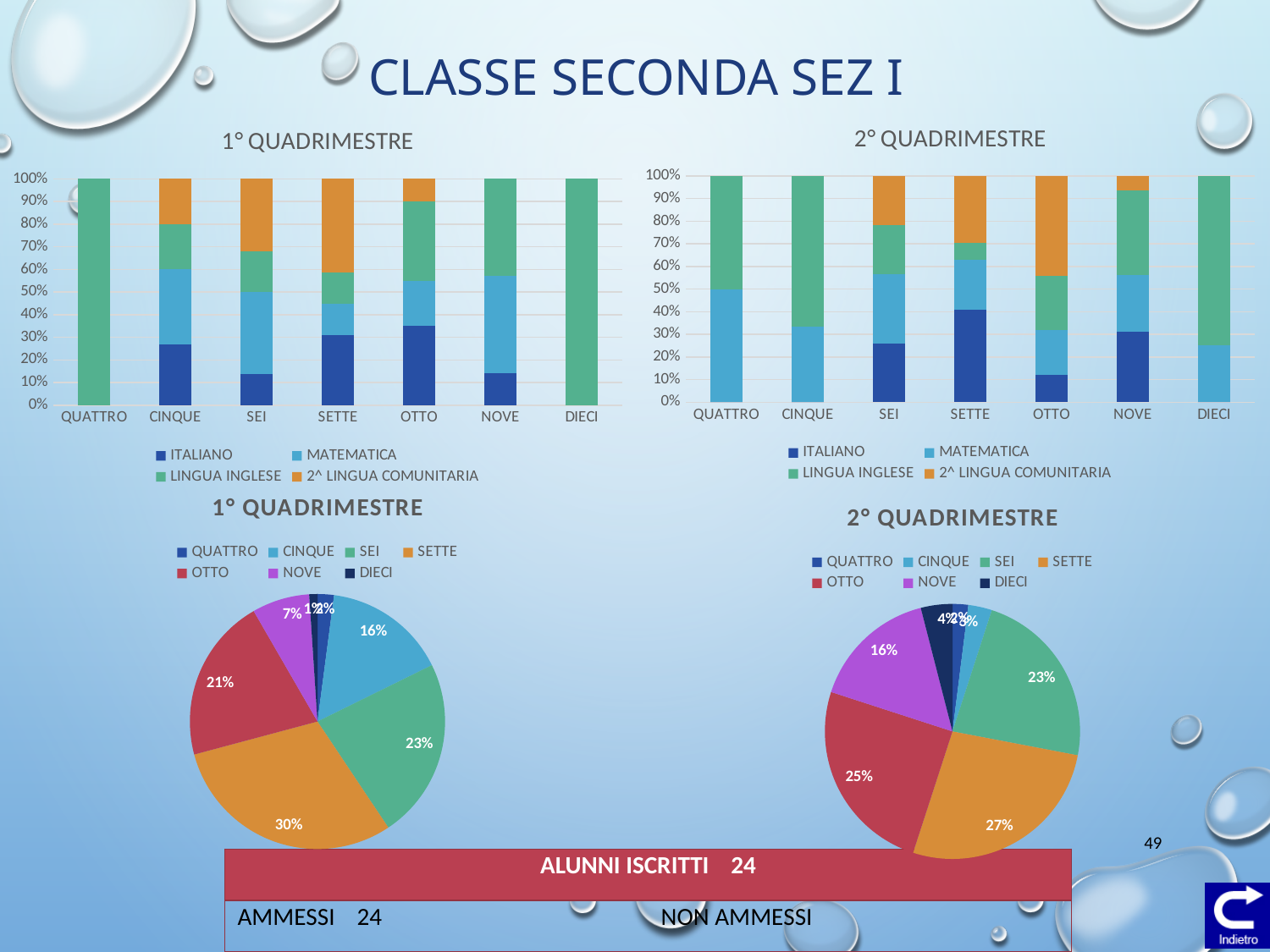
In the 2° QUADRIMESTRE pie chart, which slice is larger, OTTO or SEI? OTTO In the 1° QUADRIMESTRE pie chart, what is the difference in percentage points between SEI and CINQUE? 7 In the 1° QUADRIMESTRE pie chart, what percentage is shown for OTTO? 21% In the 1° QUADRIMESTRE stacked bar chart at the top left, how many series does the legend list? 4 In the 2° QUADRIMESTRE pie chart, what percentage is shown for NOVE? 16% In the 1° QUADRIMESTRE pie chart, which category has the largest slice? SETTE In the 1° QUADRIMESTRE stacked bar chart at the top left, how many categories are shown on the x axis? 7 In the 2° QUADRIMESTRE pie chart, what percentage is shown for SETTE? 27% In the 1° QUADRIMESTRE pie chart, what percentage is shown for SETTE? 30% In the 2° QUADRIMESTRE stacked bar chart at the top right, is the ITALIANO value for SETTE greater or less than 30%? greater What kind of chart is the 1° QUADRIMESTRE chart at the top left of the slide? Stacked bar chart In the 2° QUADRIMESTRE pie chart, which category has the largest slice? SETTE